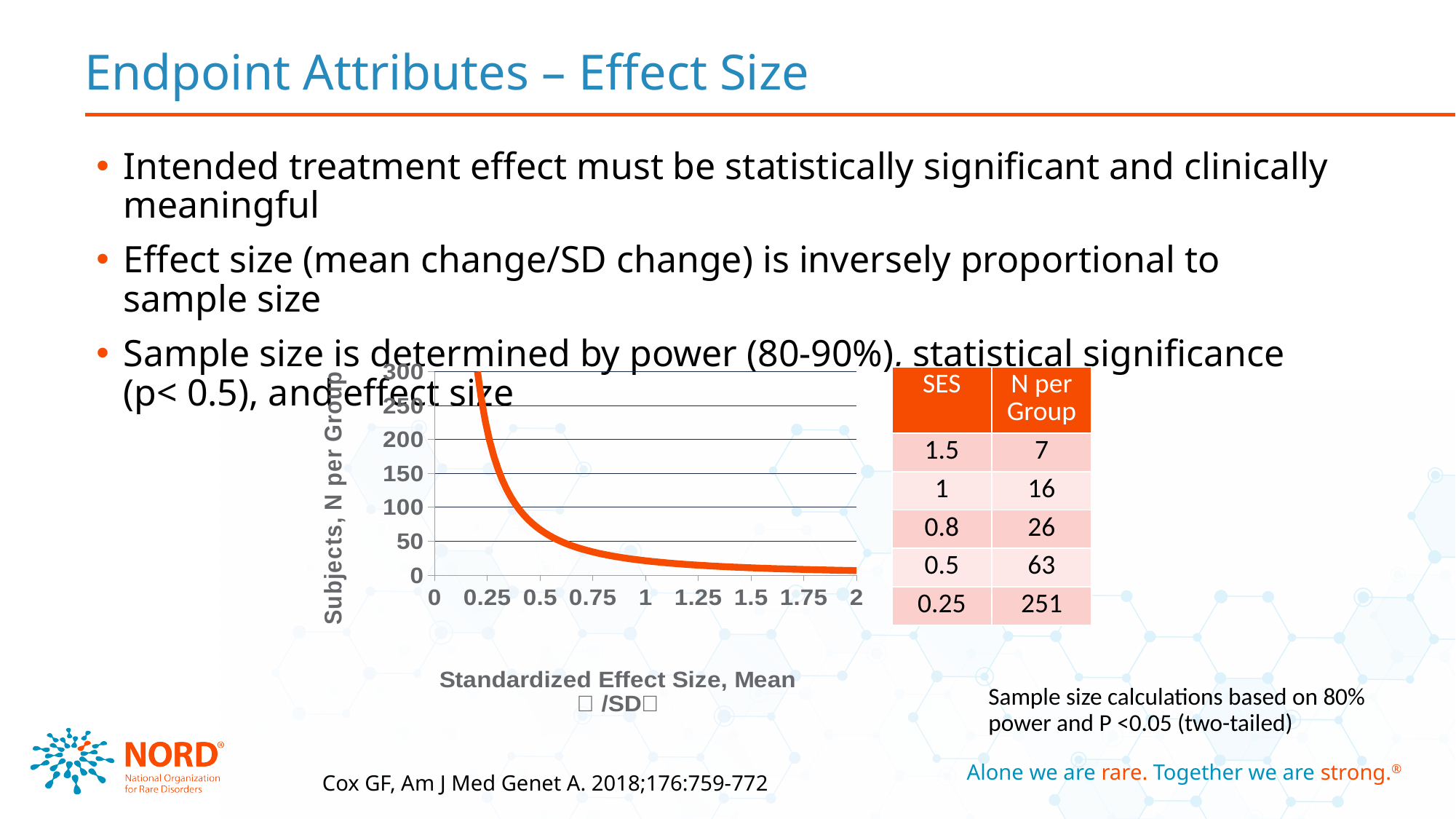
What kind of chart is shown on the slide? line chart As the standardized effect size increases along the x axis, do the subjects per group rise or fall? fall According to the table beside the chart, what is the difference in N per Group between an SES of 0.5 and an SES of 1? 47 Is the value of the curve at a standardized effect size of 2 greater or less than 50? less Is the value of the curve at a standardized effect size of 1 greater or less than 50? less What is the label of the y axis of the chart? Subjects, N per Group Is the value of the curve at a standardized effect size of 0.25 greater or less than 200? greater What is the highest tick value shown on the y axis of the chart? 300 According to the table beside the chart, what is N per Group for an SES of 0.25? 251 According to the table beside the chart, what is N per Group for an SES of 0.8? 26 According to the table beside the chart, which SES value has the lowest N per Group? 1.5